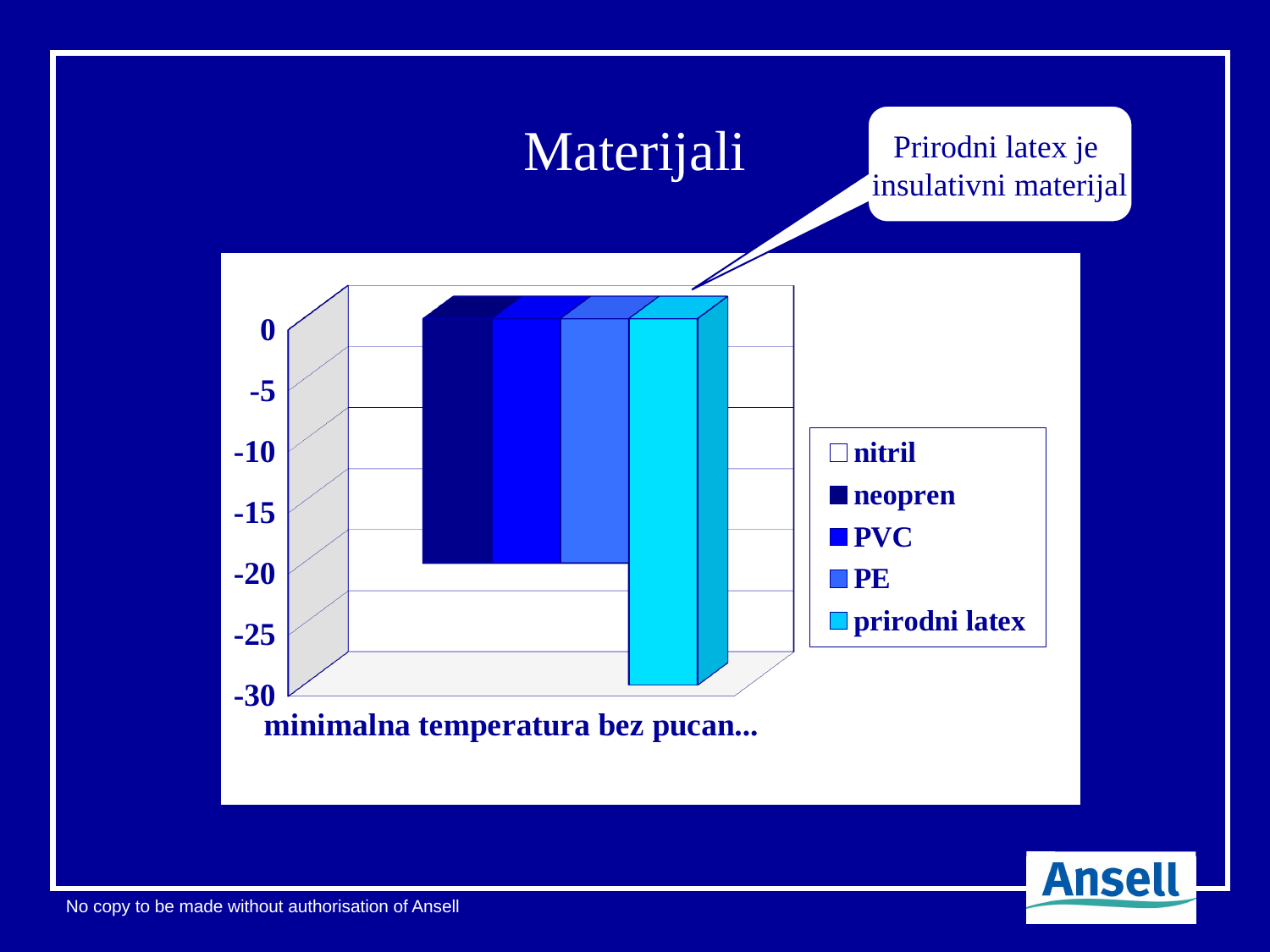
Which series has the lowest value in the chart? prirodni latex What is the axis label shown below the chart? minimalna temperatura bez pucan... How many bars are visible in the chart? 4 Is the value for PE greater or less than -10? less Is the value for prirodni latex greater or less than -25? less Which has the higher value, PE or prirodni latex? PE Is the value for neopren greater or less than -15? less Which has the higher value, neopren or prirodni latex? neopren How many series does the legend list? 5 What does the callout pointing to the chart say? Prirodni latex je insulativni materijal What kind of chart is shown on the slide? bar chart